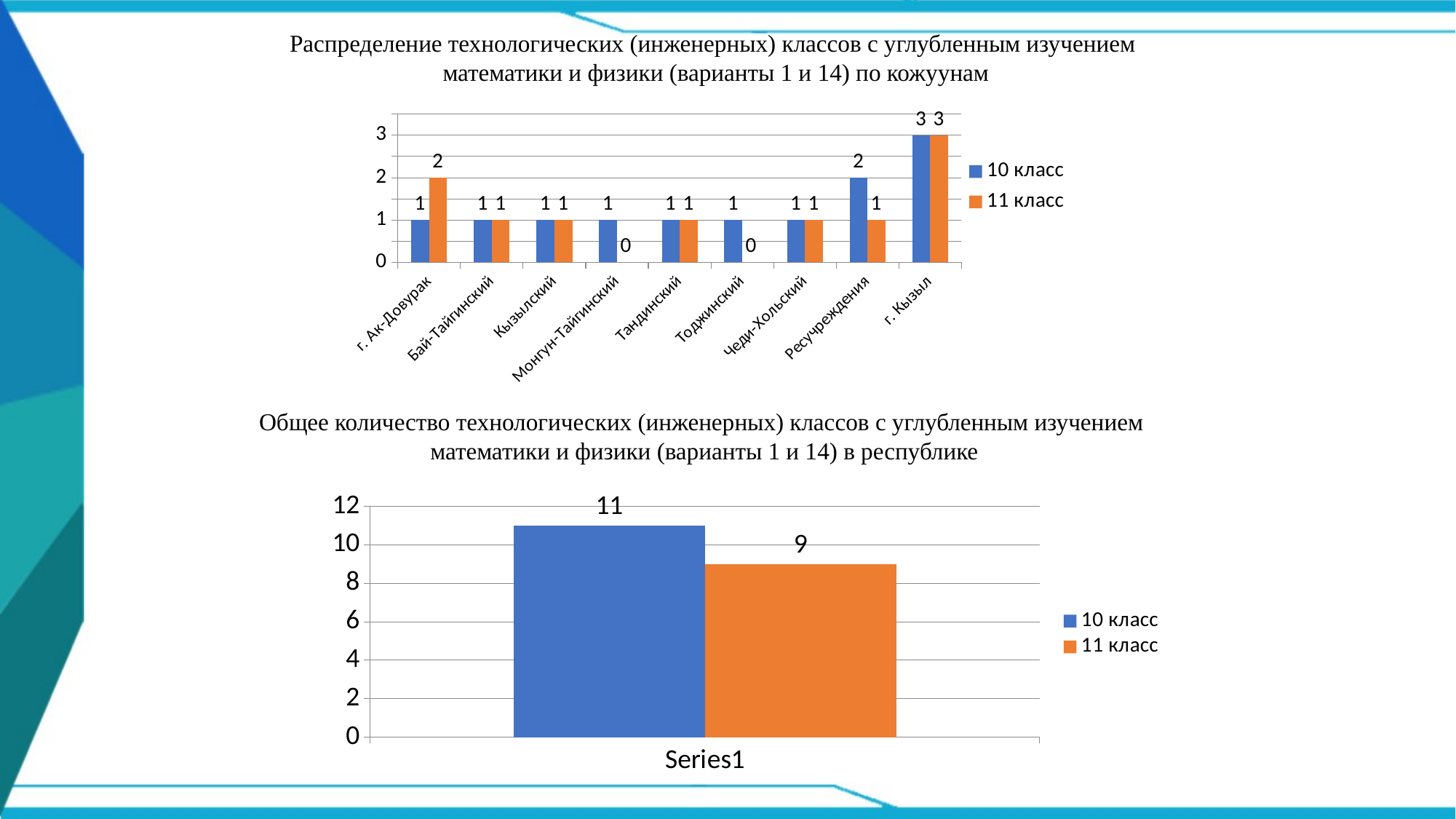
In the top chart (Распределение ... по кожуунам), how many categories are shown on the x axis? 9 In the top chart (Распределение ... по кожуунам), which category has the highest value for 10 класс? г. Кызыл In the bottom chart (Общее количество ... в республике), what is the value for 11 класс? 9 In the bottom chart (Общее количество ... в республике), what is the difference between 10 класс and 11 класс? 2 In the top chart (Распределение ... по кожуунам), what is the difference between 11 класс and 10 класс in г. Ак-Довурак? 1 What kind of chart is the bottom chart (Общее количество ... в республике)? Bar chart In the top chart (Распределение ... по кожуунам), what is the value for 11 класс in Тоджинский? 0 In the top chart (Распределение ... по кожуунам), how many series does the legend list? 2 In the top chart (Распределение ... по кожуунам), what is the value for 10 класс in Ресучреждения? 2 In the top chart (Распределение ... по кожуунам), what is the value for 11 класс in г. Ак-Довурак? 2 In the bottom chart (Общее количество ... в республике), what is the value for 10 класс? 11 In the top chart (Распределение ... по кожуунам), which is larger in Ресучреждения: 10 класс or 11 класс? 10 класс